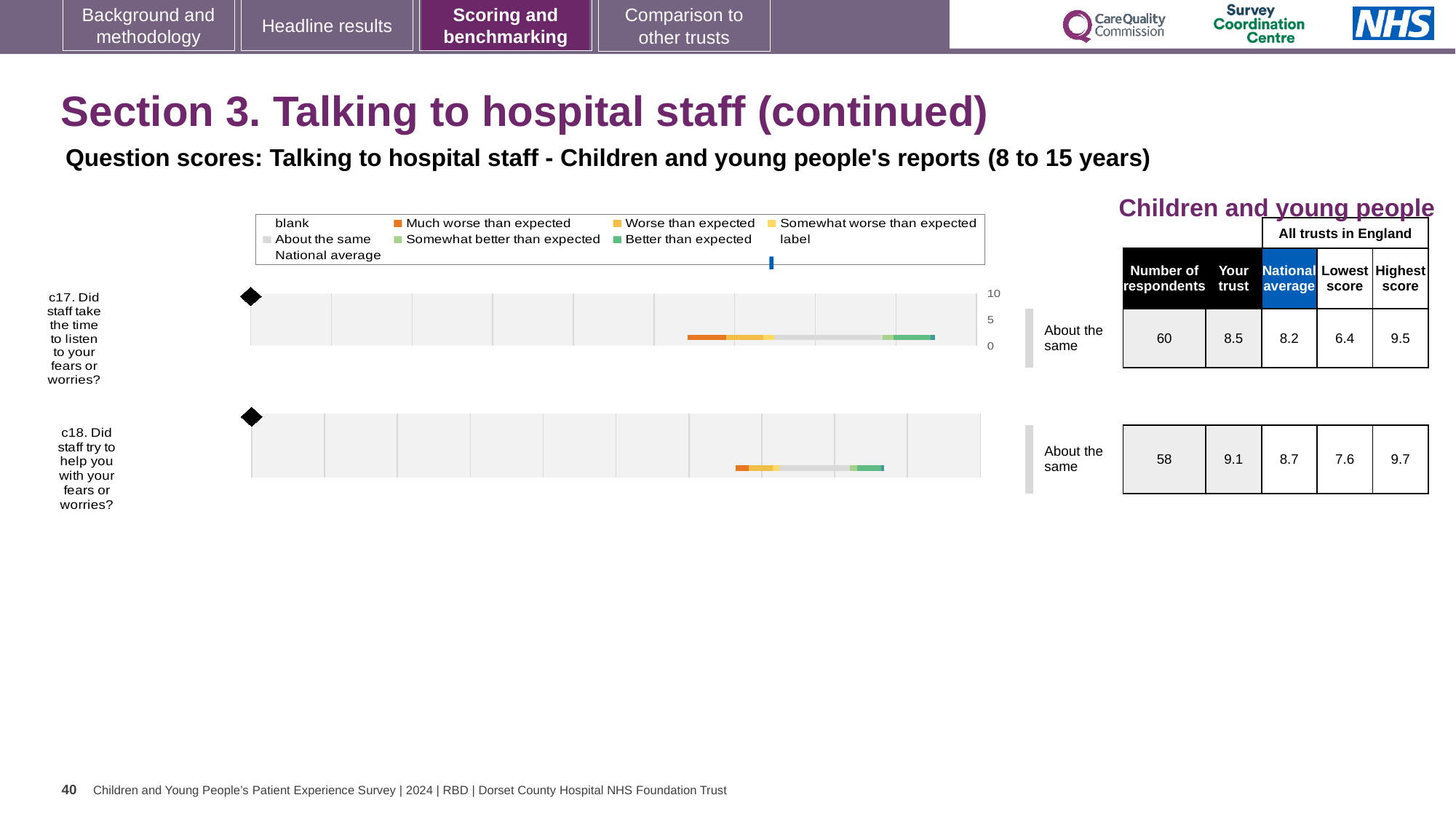
What kind of chart is used to show the question scores? Bar chart Which question has the higher 'Your trust' score, c17 or c18? c18 What is the 'Your trust' score for question c17 (Did staff take the time to listen to your fears or worries?)? 8.5 Which colour represents 'Much worse than expected' in the legend? Orange What benchmark category is shown next to the chart for question c17? About the same What is the difference between the highest and lowest trust scores in England for question c17? 3.1 What is the national average score for question c18 (Did staff try to help you with your fears or worries?)? 8.7 What is the highest score among all trusts in England for question c17? 9.5 How many respondents answered question c17? 60 How many questions are plotted on the slide? 2 What is the lowest score among all trusts in England for question c18? 7.6 For question c18, how much higher is the trust's score than the national average? 0.4